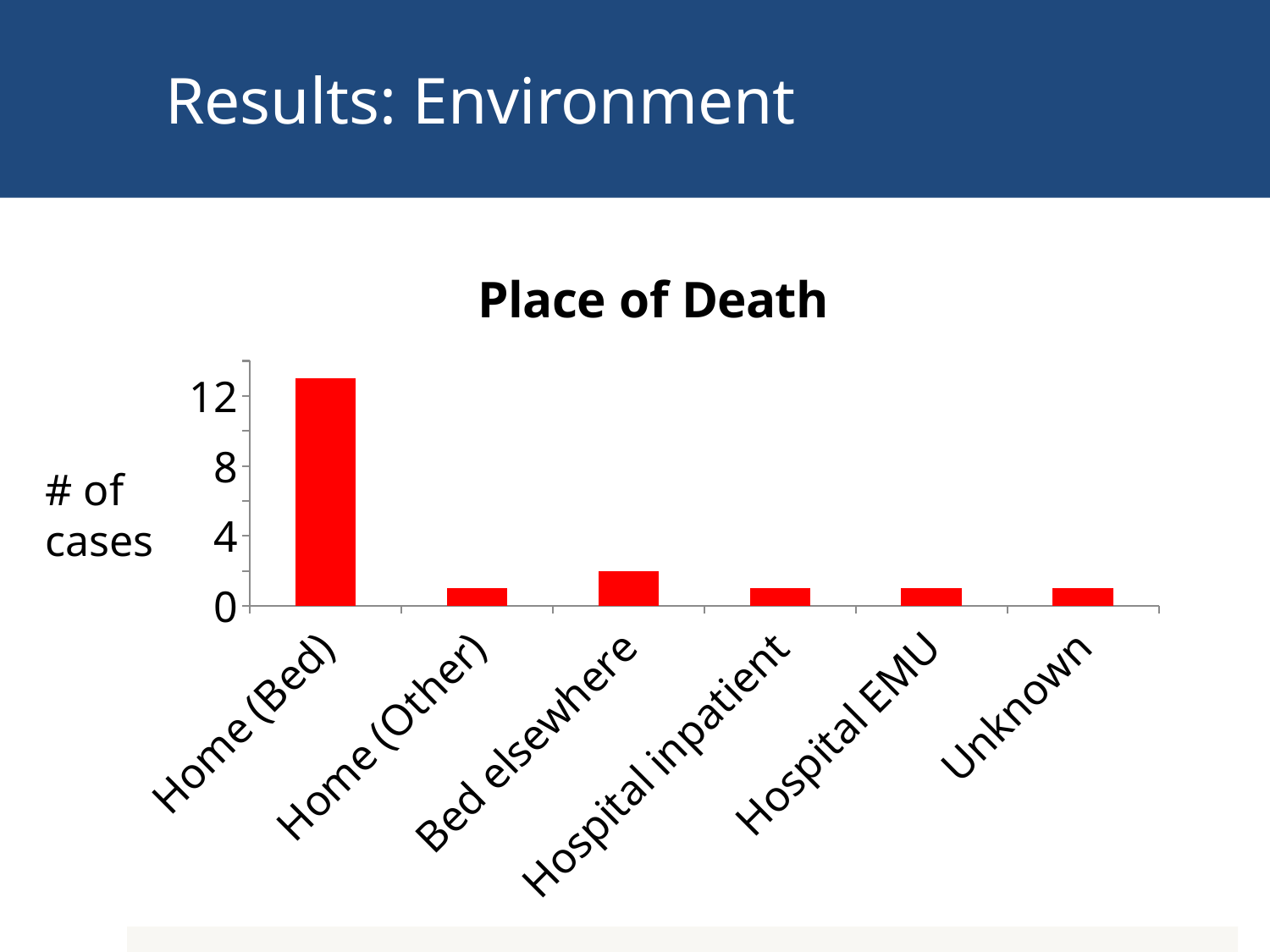
Is the value for Unknown greater or less than 8? less What type of chart is shown on the slide? bar chart Which has more cases, Home (Bed) or Hospital EMU? Home (Bed) Is the value for Bed elsewhere greater or less than 4? less Which place of death has the highest number of cases? Home (Bed) Is the value for Home (Other) greater or less than 4? less How many categories are shown on the x axis of the chart? 6 Which has more cases, Bed elsewhere or Home (Other)? Bed elsewhere What is the title of the chart? Place of Death What is the label on the vertical axis of the chart? # of cases